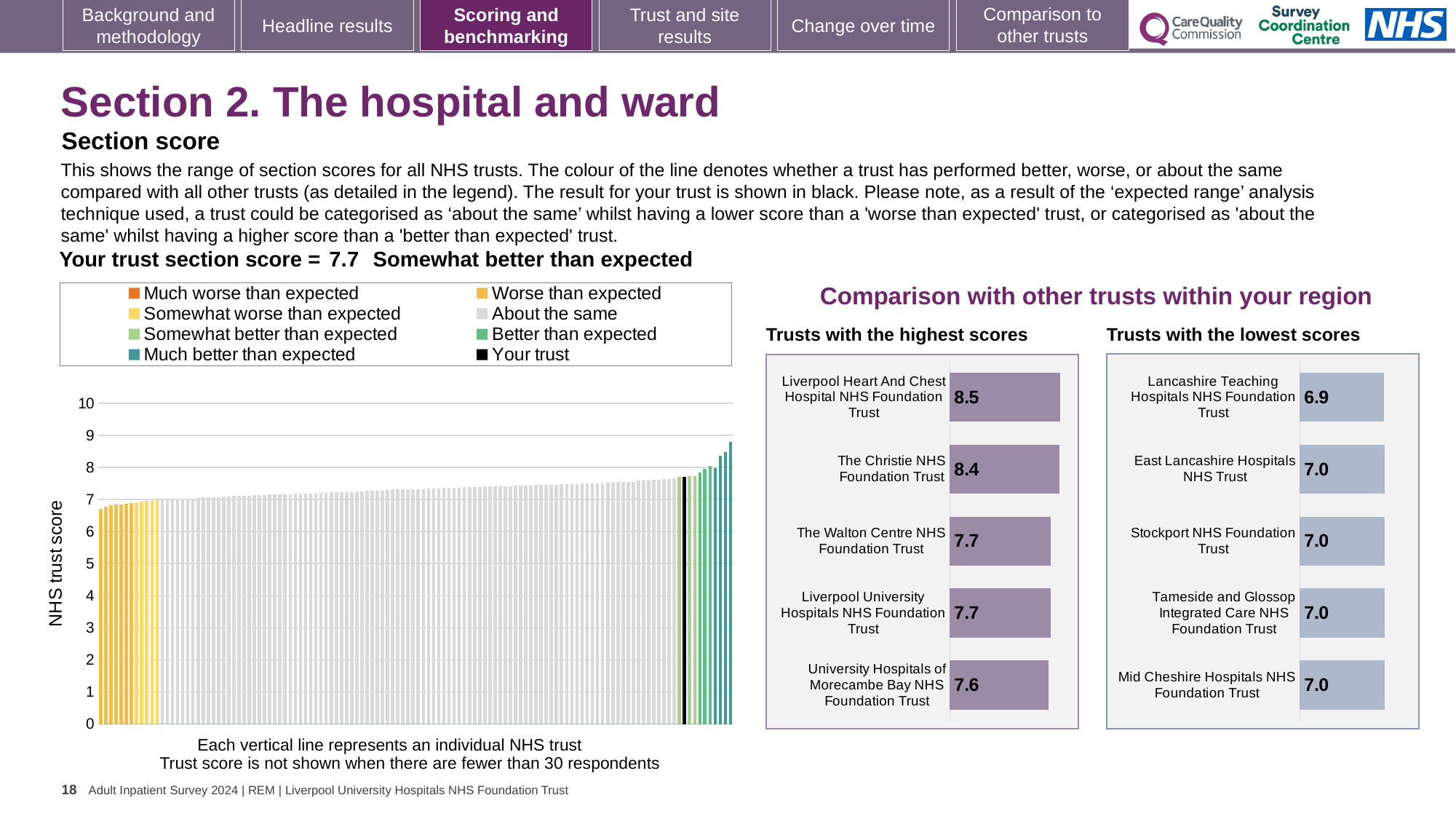
How many entries does the legend of the large chart on the left list? 8 How many trusts are shown in the 'Trusts with the lowest scores' chart? 5 In the large chart on the left, what is the section score for your trust (the black bar)? 7.7 In the 'Trusts with the highest scores' chart, what is the difference between the scores of Liverpool Heart And Chest Hospital NHS Foundation Trust and University Hospitals of Morecambe Bay NHS Foundation Trust? 0.9 In the 'Trusts with the lowest scores' chart, what is the score for Lancashire Teaching Hospitals NHS Foundation Trust? 6.9 In the large chart on the left, do the trust scores rise or fall from left to right? rise In the 'Trusts with the lowest scores' chart, which trust has the lowest score? Lancashire Teaching Hospitals NHS Foundation Trust In the 'Trusts with the highest scores' chart, what is the score for Liverpool Heart And Chest Hospital NHS Foundation Trust? 8.5 In the large chart on the left, is the value of the tallest bar greater or less than 8? greater In the 'Trusts with the highest scores' chart, which has the larger score: The Christie NHS Foundation Trust or The Walton Centre NHS Foundation Trust? The Christie NHS Foundation Trust In the 'Trusts with the highest scores' chart, what is the score for The Christie NHS Foundation Trust? 8.4 In the 'Trusts with the highest scores' chart, which trust has the highest score? Liverpool Heart And Chest Hospital NHS Foundation Trust